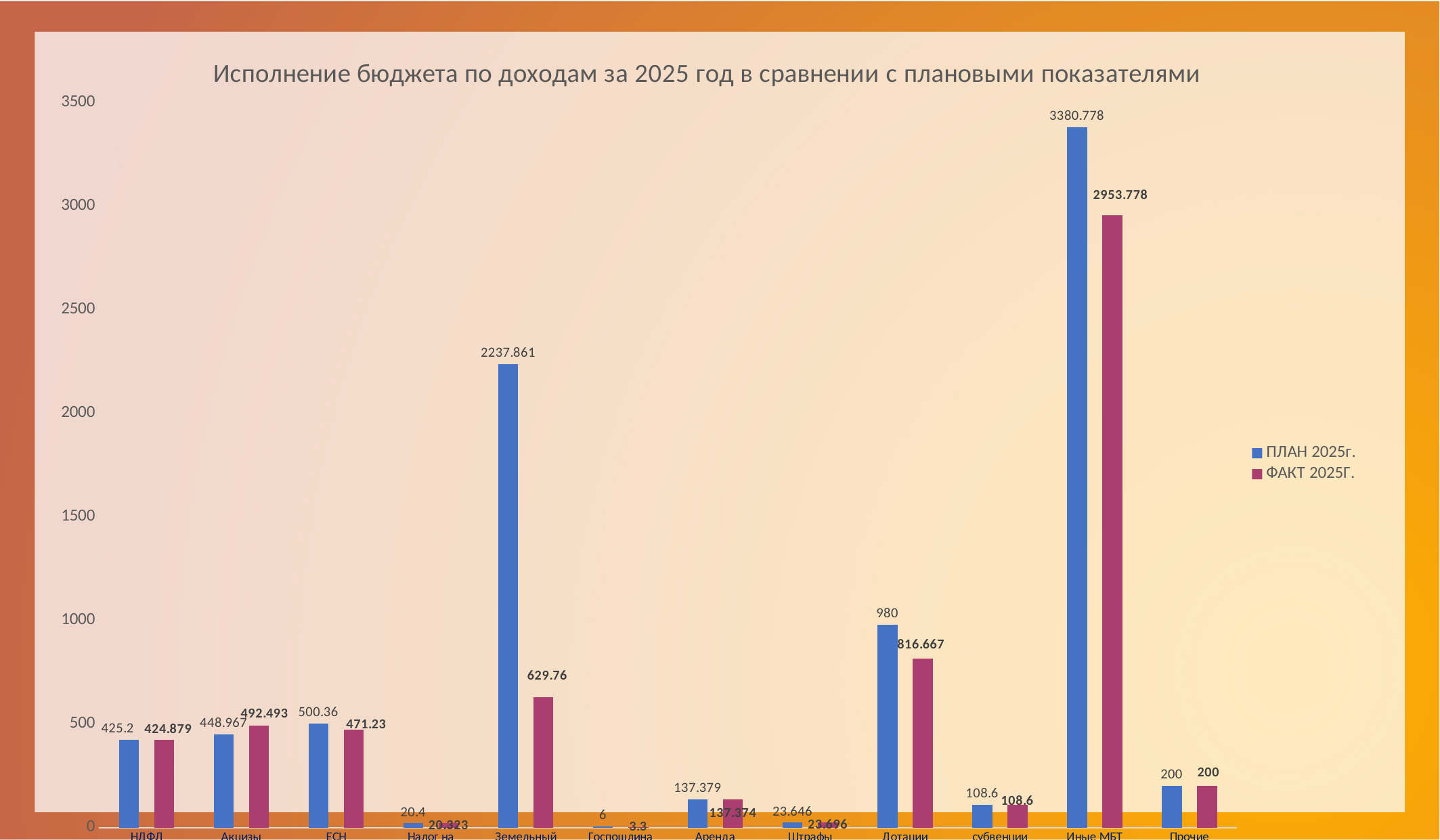
Which category has the lowest ПЛАН 2025г. value? Госпошлина How many categories are shown on the x axis? 12 What is the ФАКТ 2025Г. value for Дотации? 816.667 What is the ПЛАН 2025г. value for Земельный? 2237.861 Which category has the highest ПЛАН 2025г. value? Иные МБТ For Акцизы, which is larger: the ПЛАН 2025г. value or the ФАКТ 2025Г. value? ФАКТ 2025Г. What kind of chart is shown on the slide? Bar chart What is the ФАКТ 2025Г. value for Земельный? 629.76 What is the difference between the ПЛАН 2025г. and ФАКТ 2025Г. values for Иные МБТ? 427 What is the ПЛАН 2025г. value for ЕСН? 500.36 How many series does the legend list? 2 What is the difference between the ПЛАН 2025г. and ФАКТ 2025Г. values for Дотации? 163.333